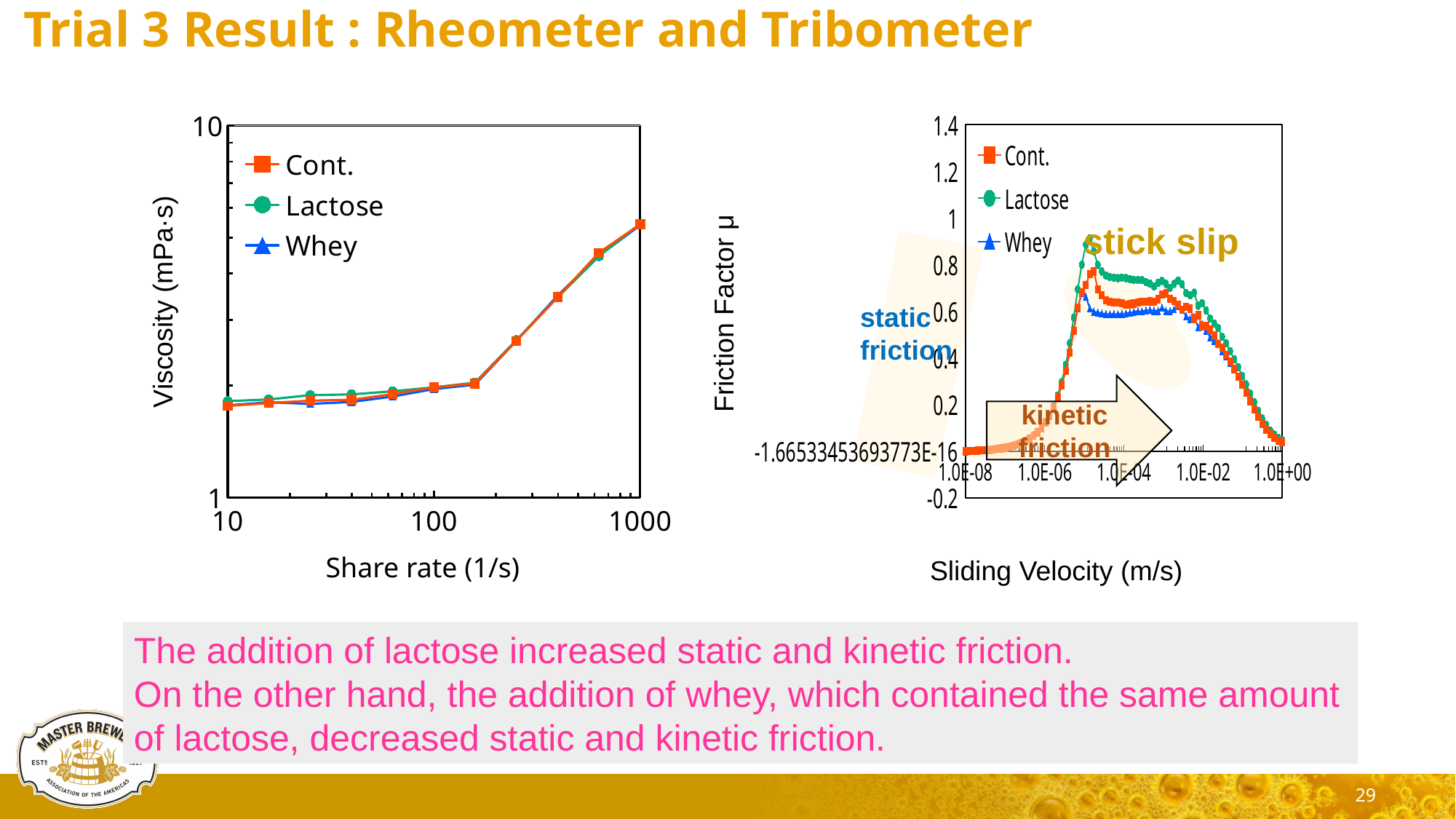
What is the x-axis label of the right chart? Sliding Velocity (m/s) What kind of chart is the left chart showing viscosity against share rate? Line chart On the left chart, does viscosity rise or fall as share rate increases from 10 to 1000? Rise On the right chart, which series has the lowest friction factor in the plateau region around 1.0E-04 m/s? Whey On the left chart, is the viscosity at a share rate of 10 greater or less than 10 mPa·s? less On the right chart, which series reaches the highest peak friction factor? Lactose On the left chart, is the viscosity at a share rate of 1000 greater or less than 1 mPa·s? greater On the left chart (Viscosity vs Share rate), how many series does the legend list? 3 On the right chart (Friction Factor vs Sliding Velocity), what are the three series named in the legend? Cont., Lactose, Whey On the right chart, is the peak friction factor for Lactose greater or less than 0.8? greater